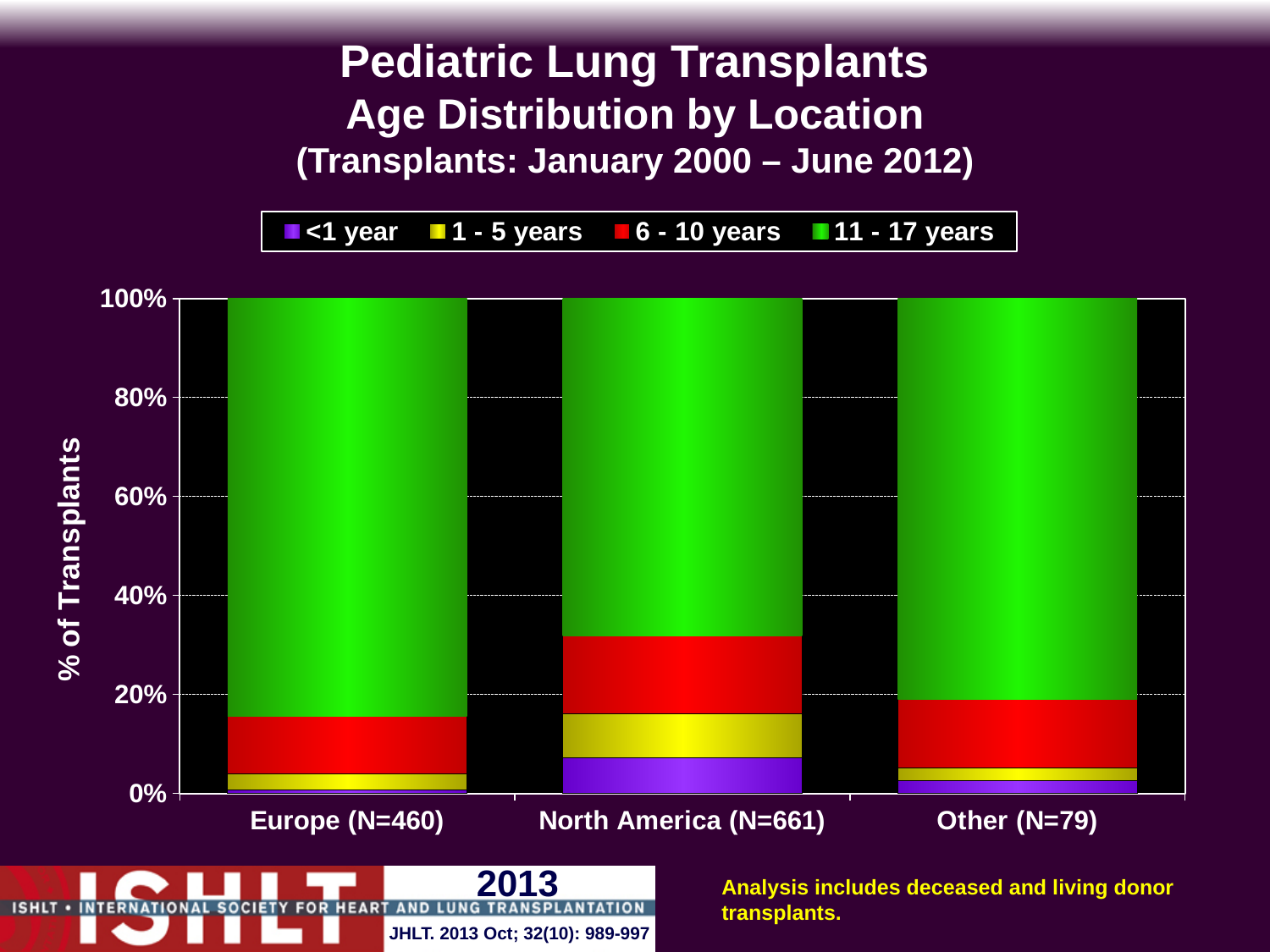
What is the label on the y axis? % of Transplants Is the 11 - 17 years share for Europe greater or less than 80%? greater What does each stacked bar total? 100% How many locations are shown on the x axis? 3 What is the N for North America shown in its category label? 661 Which location has the smallest 11 - 17 years share? North America (N=661) What kind of chart is shown on the slide? Stacked bar chart How many age groups does the legend list? 4 Is the 6 - 10 years share for North America greater or less than 20%? less Is the 11 - 17 years share for North America greater or less than 80%? less Which location has the largest <1 year share? North America (N=661) Which has the larger 6 - 10 years share, Europe or North America? North America